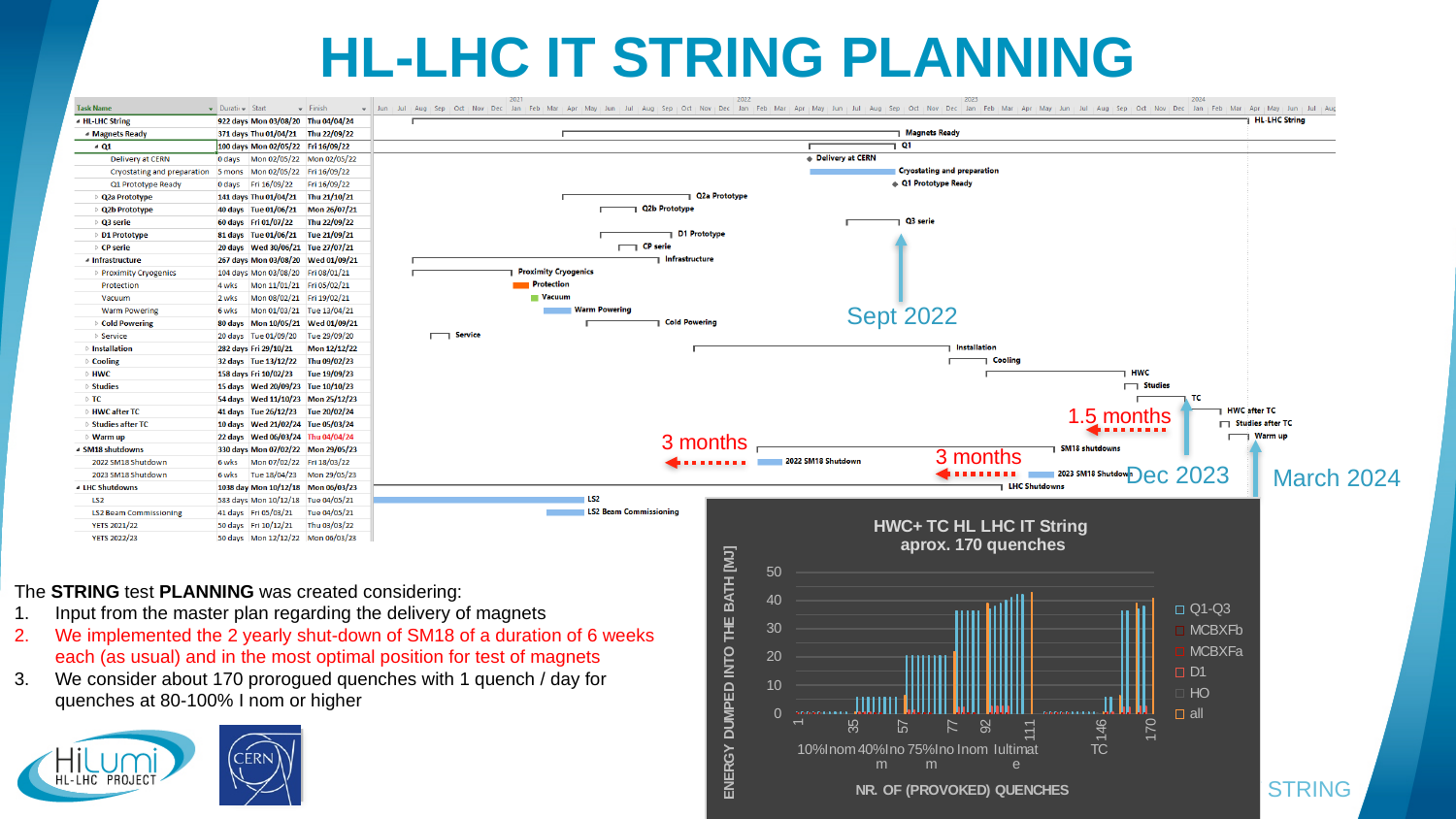
In the 'HWC+ TC HL LHC IT String' chart, is the energy dumped for the quenches around number 57 greater or less than 30? less In the 'HWC+ TC HL LHC IT String' chart, what is the highest value shown on the vertical axis? 50 In the 'HWC+ TC HL LHC IT String' chart, is the energy dumped for the quenches around number 57 greater or less than 10? less How many series does the legend of the 'HWC+ TC HL LHC IT String' chart list? 6 In the 'HWC+ TC HL LHC IT String' chart, what is the last quench number shown on the horizontal axis? 170 In the 'HWC+ TC HL LHC IT String' chart, is the energy dumped for the quenches around number 35 greater or less than 10? less In the 'HWC+ TC HL LHC IT String' chart, what is the label of the vertical axis? ENERGY DUMPED INTO THE BATH [MJ] In the 'HWC+ TC HL LHC IT String' chart, which is larger: the energy dumped for the quenches around number 92 or around number 35? around number 92 What kind of chart is the 'HWC+ TC HL LHC IT String' chart at the bottom right of the slide? bar chart In the 'HWC+ TC HL LHC IT String' chart, do the bar heights generally rise or fall from quench number 1 to quench number 111? rise In the 'HWC+ TC HL LHC IT String' chart, what is the label of the horizontal axis? NR. OF (PROVOKED) QUENCHES